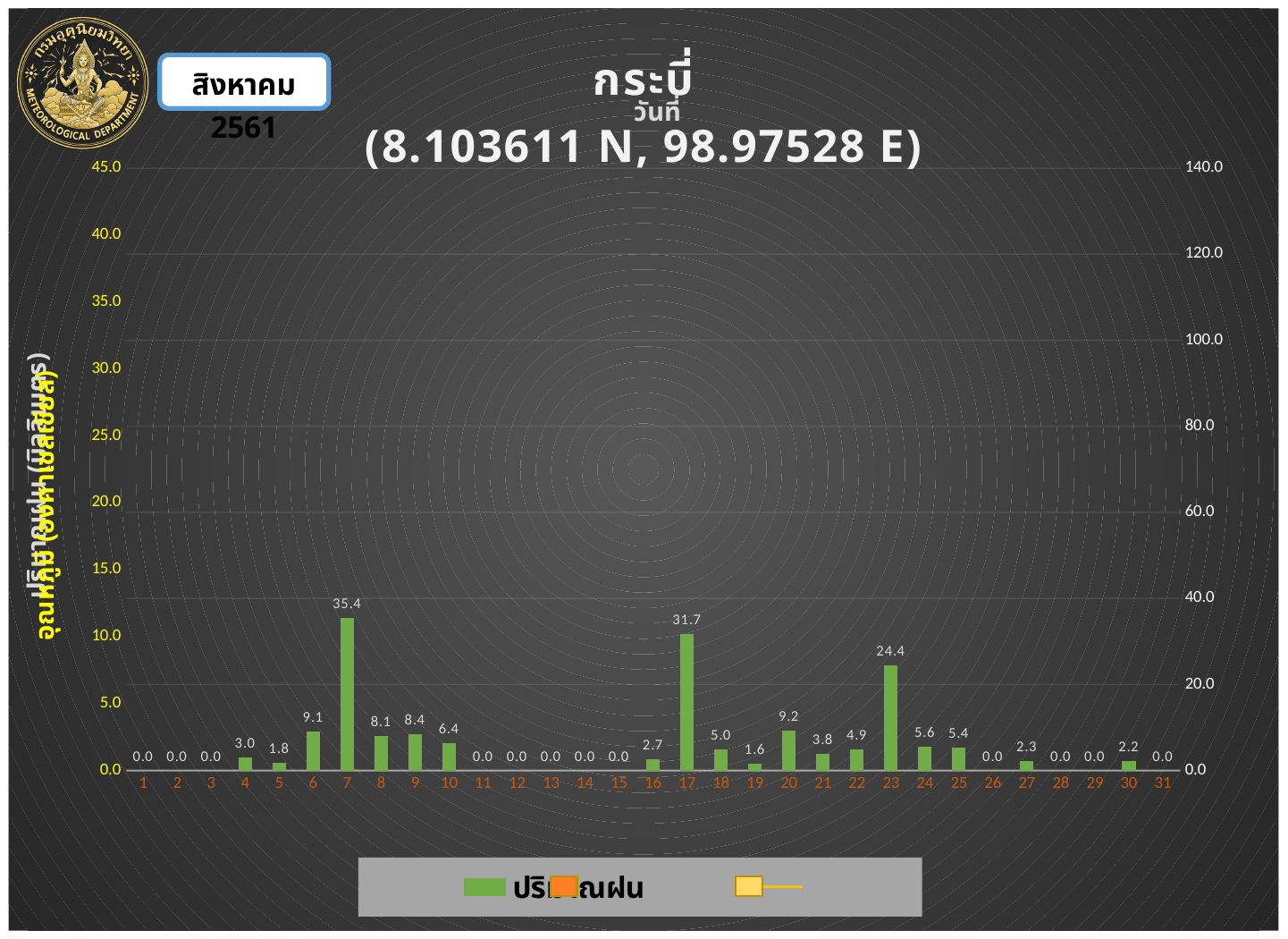
Which day has the highest rainfall value? 7 What type of chart is used to show the rainfall data? bar chart What coordinates are given in the chart title? (8.103611 N, 98.97528 E) What colour are the rainfall bars? green What is the rainfall value shown for day 23? 24.4 What is the rainfall value shown for day 17? 31.7 What is the rainfall value shown for day 7? 35.4 What is the difference between the rainfall values for day 7 and day 17? 3.7 How many days (categories) are shown on the x axis? 31 What is the rainfall value shown for day 20? 9.2 Which is larger, the rainfall value for day 6 or for day 10? day 6 What is the difference between the rainfall values for day 23 and day 20? 15.2